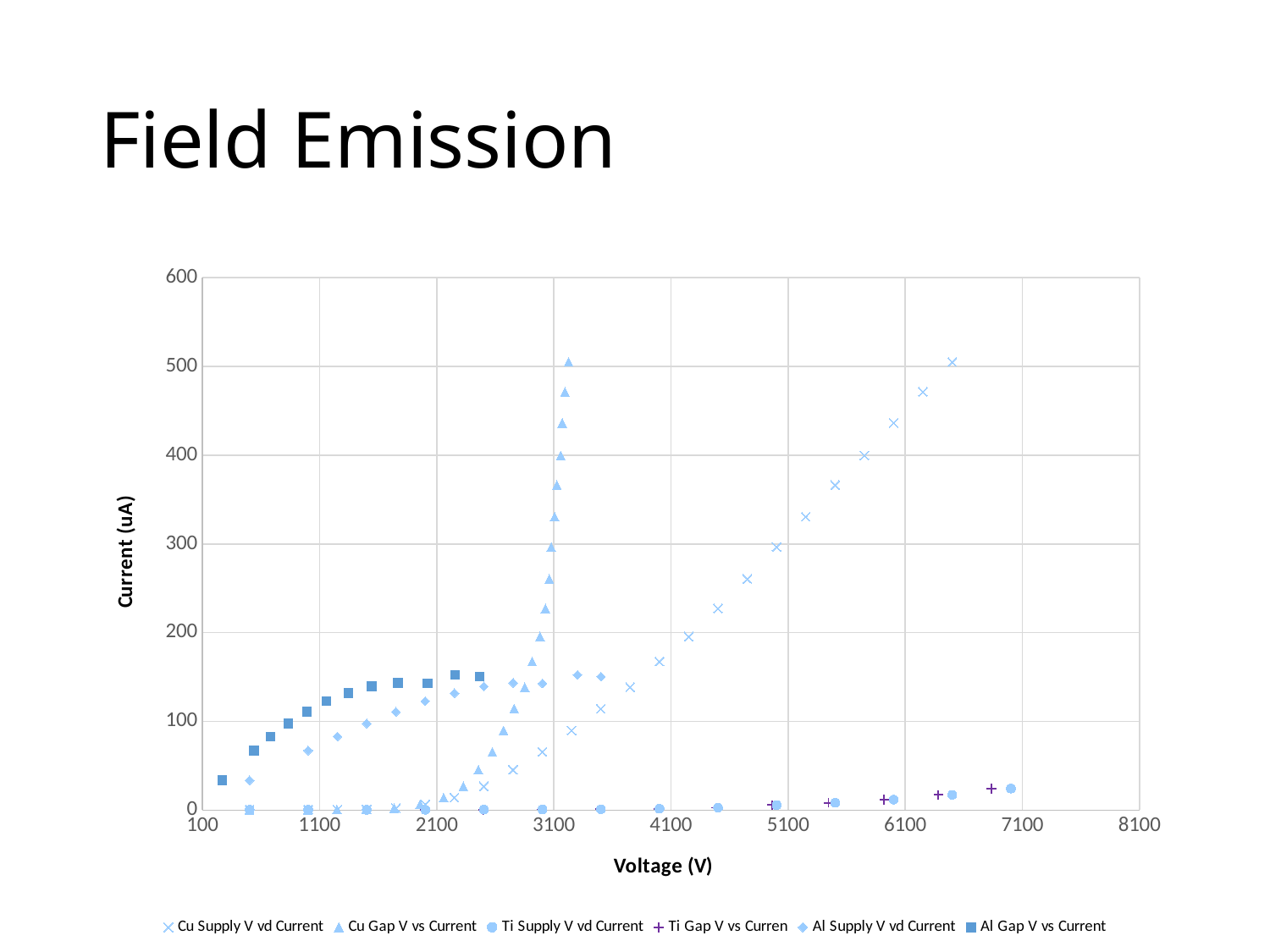
How many series does the legend list? 6 Which series reaches a higher current, Al Supply V vd Current or Ti Supply V vd Current? Al Supply V vd Current Is the highest value for Al Gap V vs Current greater or less than 200? less What kind of chart is shown on the slide? scatter chart Is the highest value for Cu Gap V vs Current greater or less than 400? greater Is the highest value for Ti Supply V vd Current greater or less than 100? less Which series reaches a higher current, Cu Gap V vs Current or Ti Gap V vs Curren? Cu Gap V vs Current How many series have points above 300 on the current axis? 2 What is the title of the vertical axis? Current (uA) Do the values for Cu Supply V vd Current rise or fall as voltage increases? rise What is the title of the horizontal axis? Voltage (V)